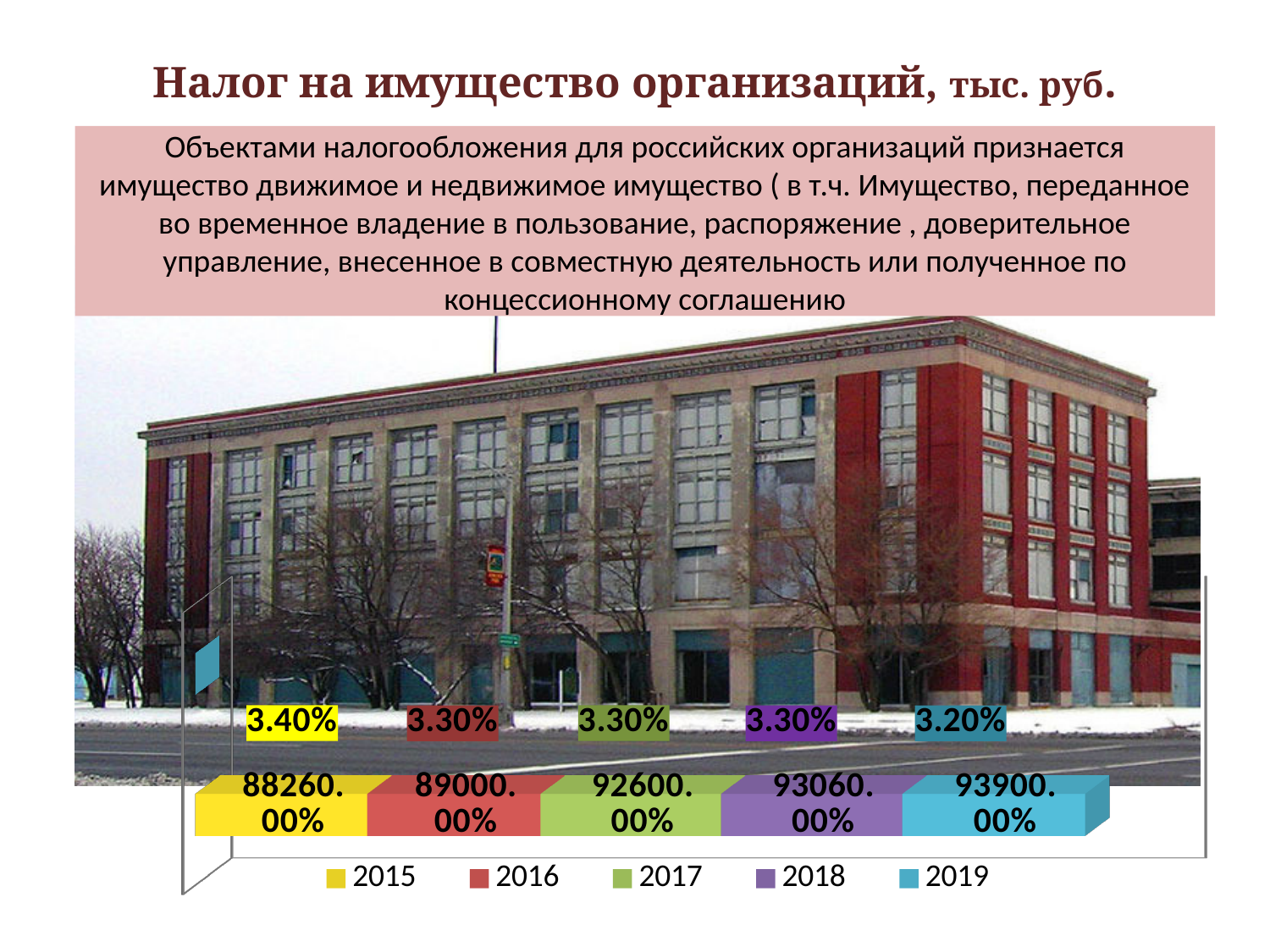
What is the value shown for 2017 in the lower row of data labels? 92600.00% What is the value shown for 2019 in the lower row of data labels? 93900.00% Do the values in the lower row of data labels rise or fall from 2015 to 2019? rise What is the value shown for 2015 in the lower row of data labels? 88260.00% What kind of chart is shown on the slide? bar chart Which year has the lowest value in the lower row of data labels? 2015 Which is larger in the lower row of data labels, the value for 2016 or the value for 2017? 2017 Which year has the lowest value in the upper row of data labels? 2019 How many entries does the legend list? 5 What is the difference between the 2019 and 2015 values in the lower row of data labels? 5640.00% What is the value shown for 2015 in the upper row of data labels? 3.40% Which year has the highest value in the lower row of data labels? 2019